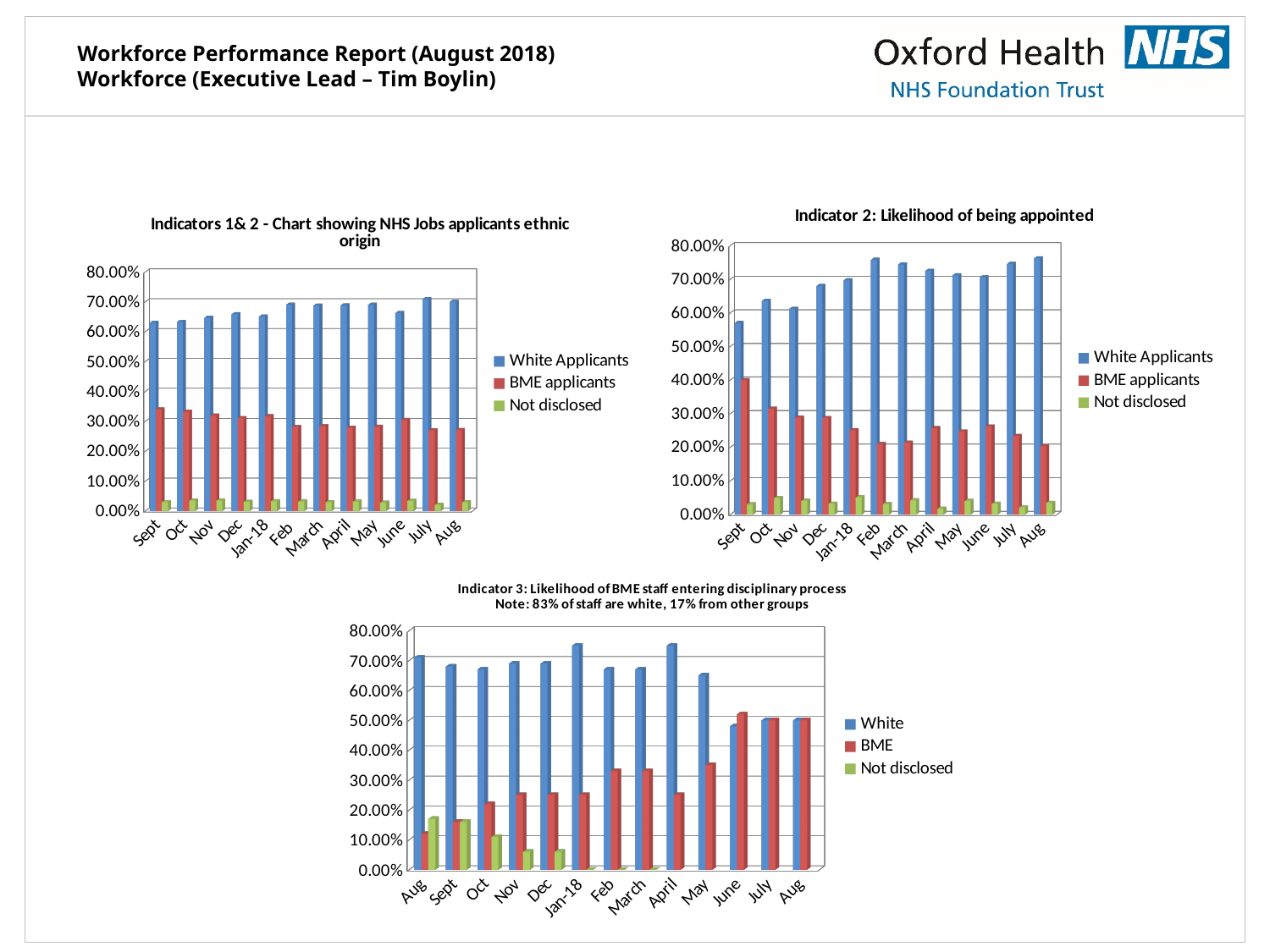
In the 'Indicator 2: Likelihood of being appointed' chart, is the value for BME applicants in Aug greater or less than 30.00%? less In the 'Indicators 1& 2 - Chart showing NHS Jobs applicants ethnic origin' chart, is the value for BME applicants in Aug greater or less than 30.00%? less How many months are shown on the x axis of the 'Indicator 3: Likelihood of BME staff entering disciplinary process' chart? 13 In the 'Indicator 2: Likelihood of being appointed' chart, which month has the highest value for BME applicants? Sept In the 'Indicator 2: Likelihood of being appointed' chart, is the value for White Applicants in Sept greater or less than 60.00%? less In the 'Indicator 3: Likelihood of BME staff entering disciplinary process' chart, which is larger in June, White or BME? BME In the 'Indicator 3: Likelihood of BME staff entering disciplinary process' chart, which month has the lowest value for White? June In the 'Indicator 2: Likelihood of being appointed' chart, which month has the lowest value for White Applicants? Sept How many series does the legend list in the 'Indicators 1& 2 - Chart showing NHS Jobs applicants ethnic origin' chart? 3 How many months are shown on the x axis of the 'Indicator 2: Likelihood of being appointed' chart? 12 What type of chart is the 'Indicator 2: Likelihood of being appointed' chart? bar chart